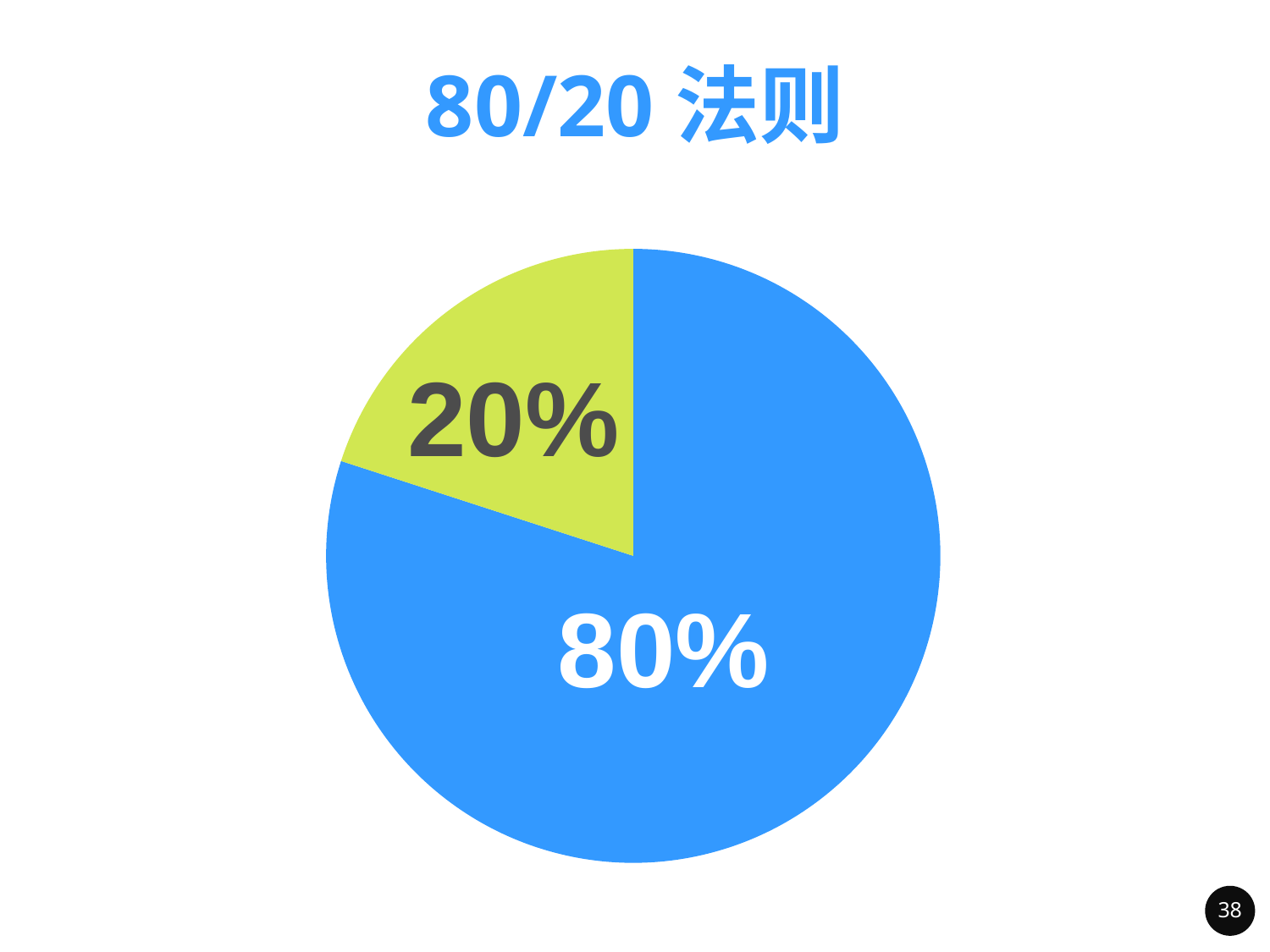
What share of the pie does the green slice represent? 20% How many slices does the pie chart have? 2 What kind of chart is shown on the slide? pie chart What is the difference between the blue slice and the green slice in the pie chart? 60% What colour is the slice labelled 80%? blue Which is larger in the pie chart, the blue slice or the green slice? the blue slice Which slice of the pie chart is the largest? the blue slice (80%) What is the total of the two slices shown in the pie chart? 100% What is the title of the slide? 80/20 法则 What percentage is shown on the blue slice of the pie chart? 80% Which slice of the pie chart is the smallest? the green slice (20%) What percentage is shown on the green slice of the pie chart? 20%